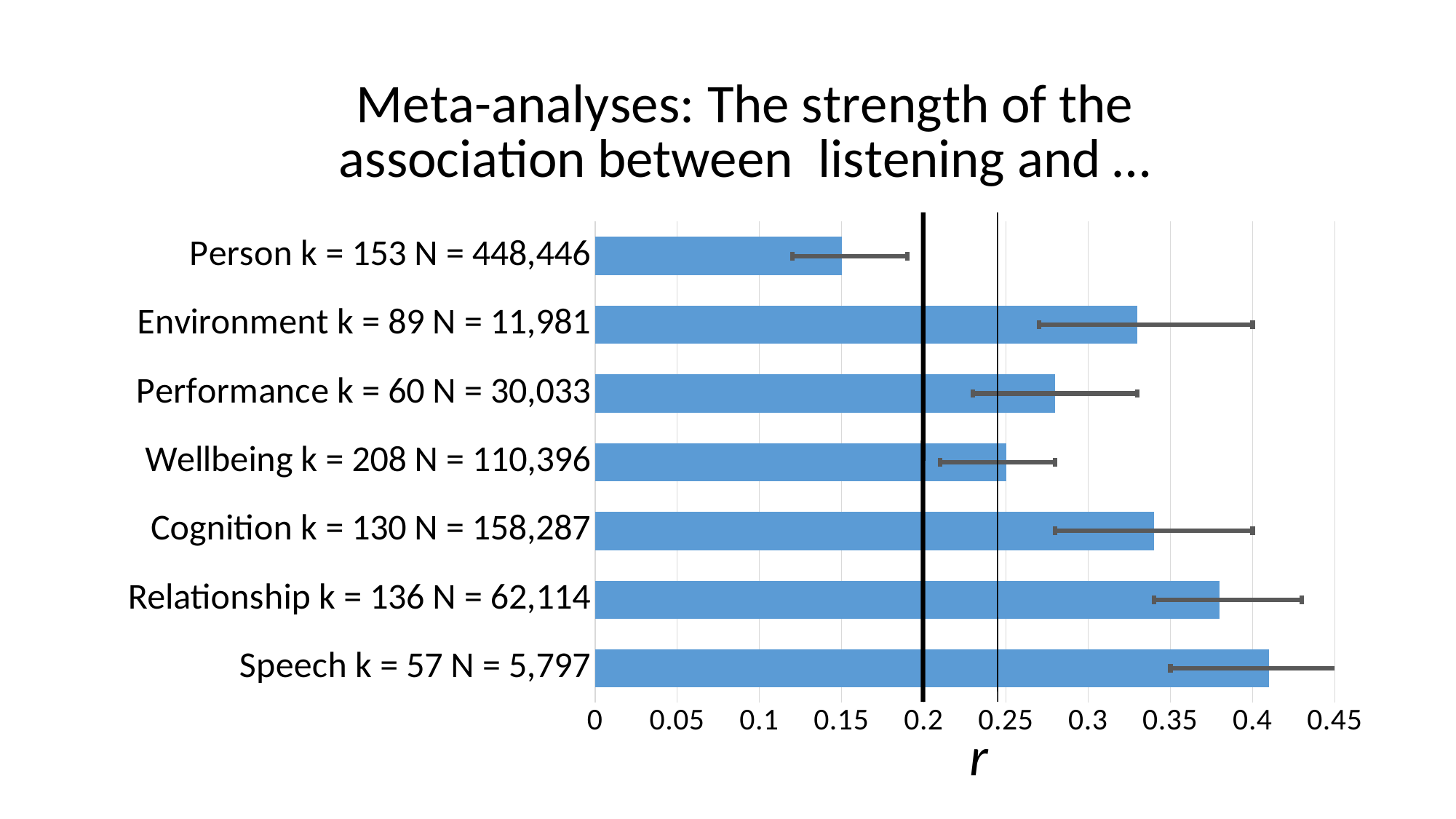
Is the value for Person k = 153 N = 448,446 greater or less than 0.2? less Which category has the lowest value of r? Person k = 153 N = 448,446 How many categories (bars) does the chart show? 7 What kind of chart is shown on the slide? bar chart Which has the larger value: Relationship k = 136 N = 62,114 or Cognition k = 130 N = 158,287? Relationship k = 136 N = 62,114 Is the value for Environment k = 89 N = 11,981 greater or less than 0.3? greater Which category has the highest value of r? Speech k = 57 N = 5,797 Is the value for Relationship k = 136 N = 62,114 greater or less than 0.35? greater What is the label on the horizontal axis of the chart? r Which has the larger value: Environment k = 89 N = 11,981 or Performance k = 60 N = 30,033? Environment k = 89 N = 11,981